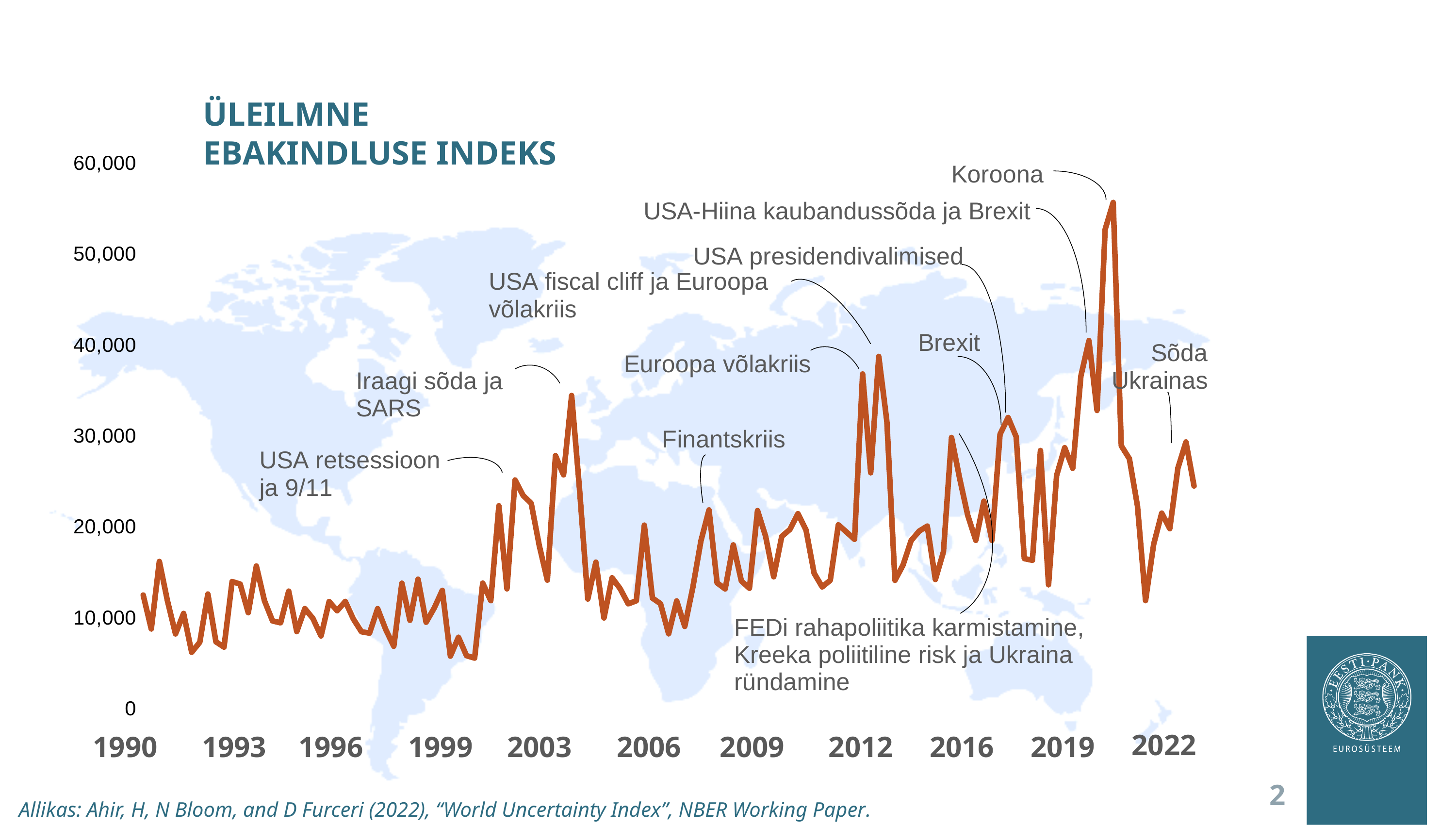
What is the title of the chart? ÜLEILMNE EBAKINDLUSE INDEKS Which annotated event corresponds to the highest peak of the index? Koroona Is the peak of the index labelled "Iraagi sõda ja SARS" greater or less than 30,000? greater What is the highest value shown on the y axis? 60,000 Is the peak of the index labelled "Euroopa võlakriis" greater or less than 30,000? greater Is the peak of the index labelled "Brexit" greater or less than 40,000? less How many year labels are shown on the x axis? 11 What kind of chart is shown on the slide? line chart Which peak is higher: the one labelled "Koroona" or the one labelled "Brexit"? Koroona